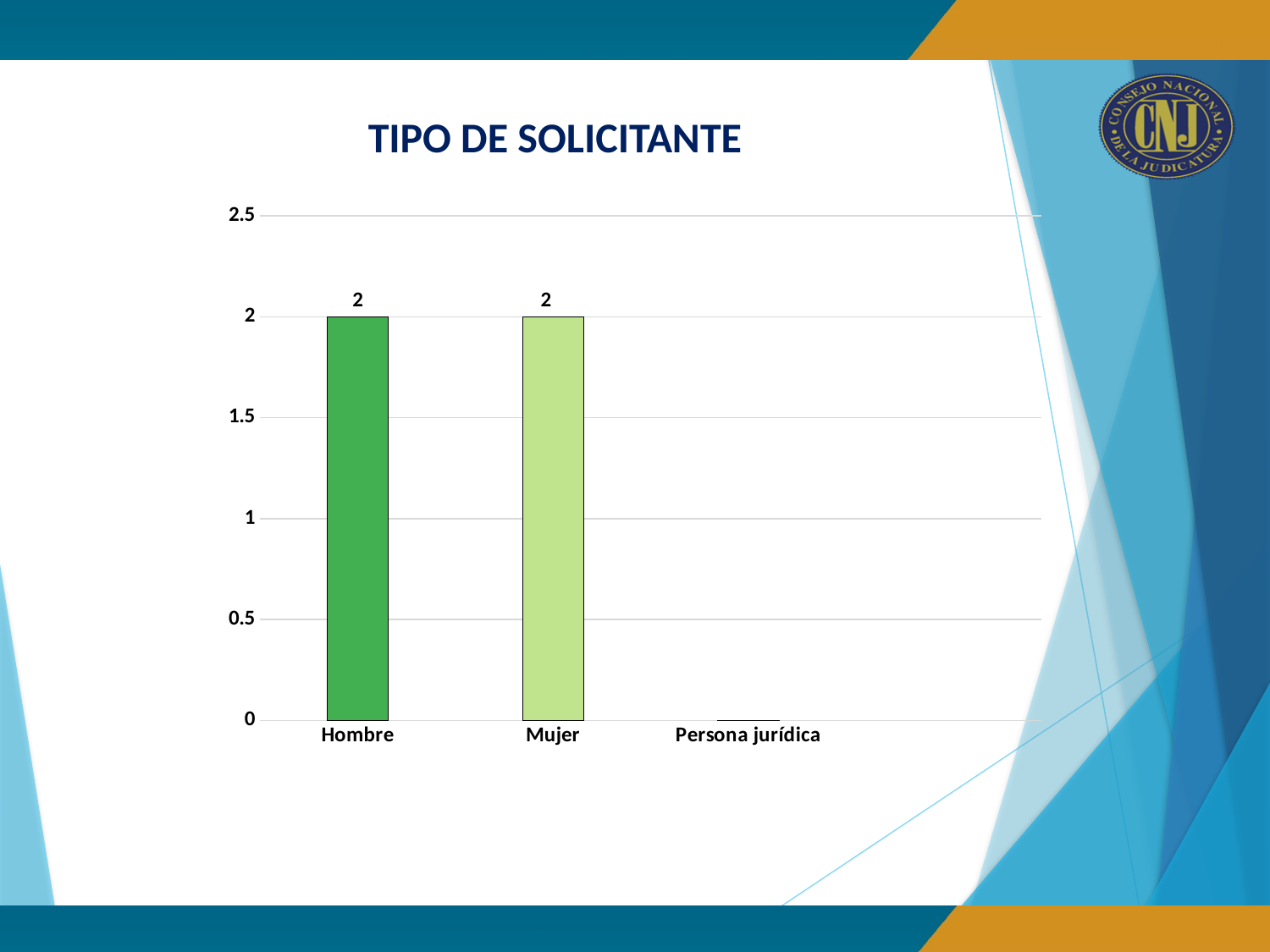
What is the highest value shown on the y axis? 2.5 What is the value for Mujer? 2 What kind of chart is shown on the slide? bar chart Which category has the lowest value? Persona jurídica What is the difference between the values for Hombre and Mujer? 0 What is the value for Hombre? 2 How many categories are shown on the x axis? 3 Is the value for Hombre greater or less than 1.5? greater What is the title of the chart? TIPO DE SOLICITANTE What colour is the bar for Mujer? light green Is the value for Persona jurídica greater or less than 1? less